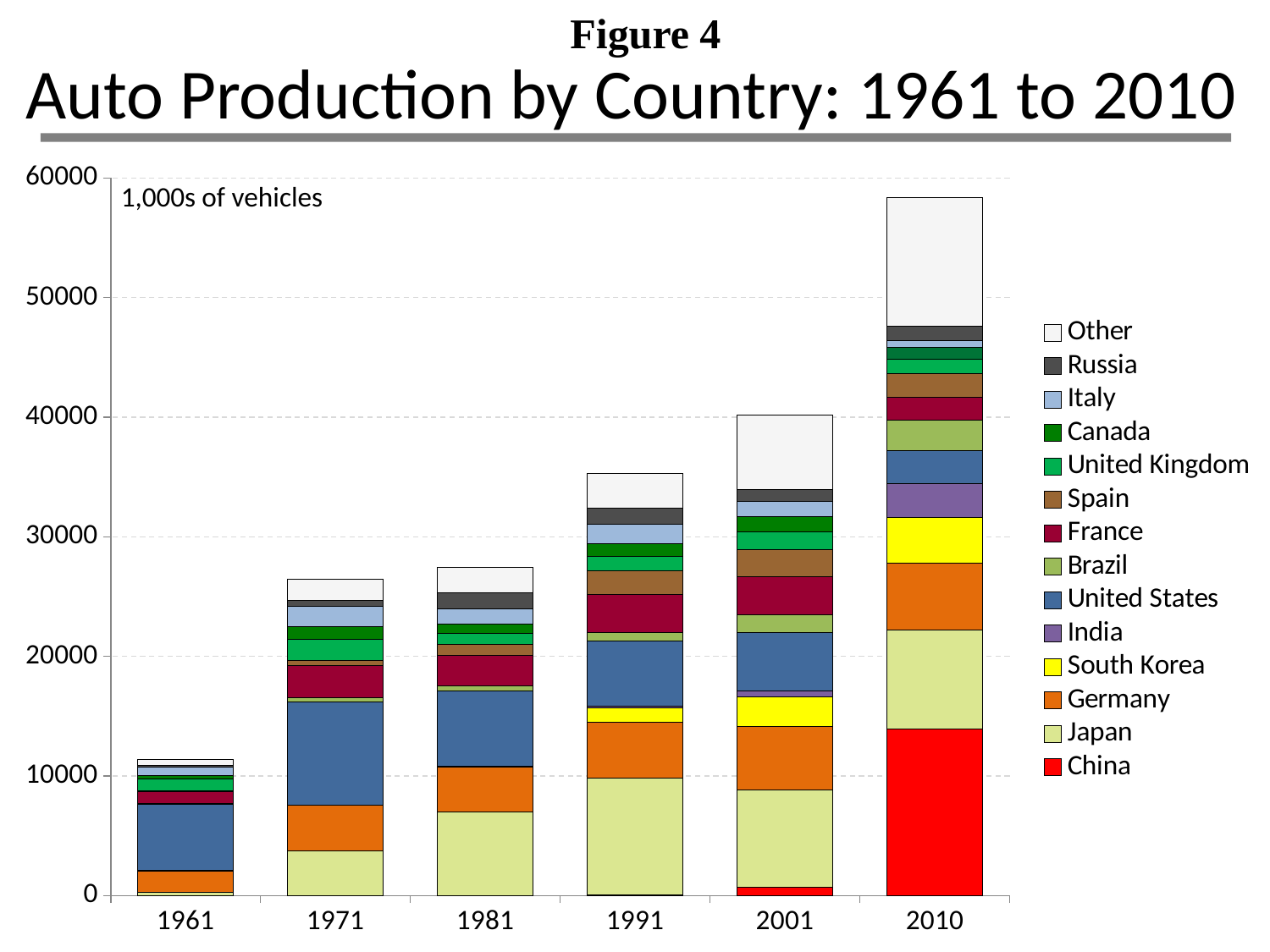
Is the total value for 2010 greater or less than 50000? greater Is the total value for 1991 greater or less than 30000? greater What kind of chart is shown on the slide? stacked bar chart What unit is stated for the values on the chart? 1,000s of vehicles Which year has the highest total auto production? 2010 Which year has the larger total bar, 2001 or 2010? 2010 Is the total value for 1971 greater or less than 30000? less How many years are shown along the x axis? 6 How many series does the legend list? 14 Which country is shown at the bottom of each stacked bar? China Do the total bar heights rise or fall from 1961 to 2010? rise Which year has the lowest total auto production? 1961